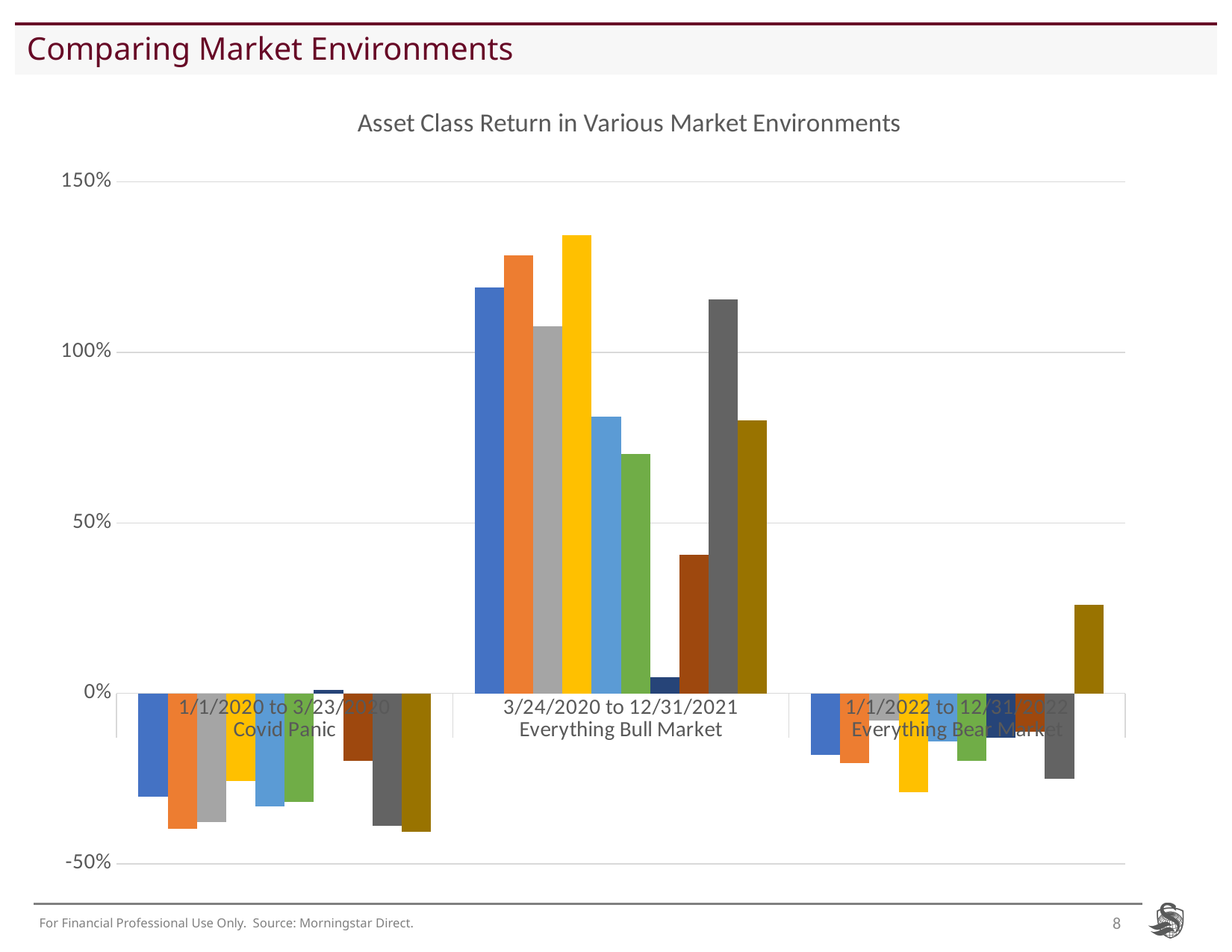
How many bars in the Everything Bear Market group are above 0%? 1 How many bars are plotted in each market environment group? 10 Is the tallest bar in the Everything Bull Market group greater or less than 100%? greater What type of chart is shown on the slide? Bar chart What is the highest value shown on the y axis? 150% What is the title of the chart? Asset Class Return in Various Market Environments How many market environment categories are shown on the x axis? 3 Which market environment has all of its bars above 0%? 3/24/2020 to 12/31/2021 Everything Bull Market Is the green bar in the Everything Bull Market group greater or less than 100%? less Which group contains the lowest bar on the chart, Covid Panic or Everything Bear Market? Covid Panic Is the lowest bar in the Everything Bear Market group greater or less than -50%? greater What date range is given for the Covid Panic environment? 1/1/2020 to 3/23/2020